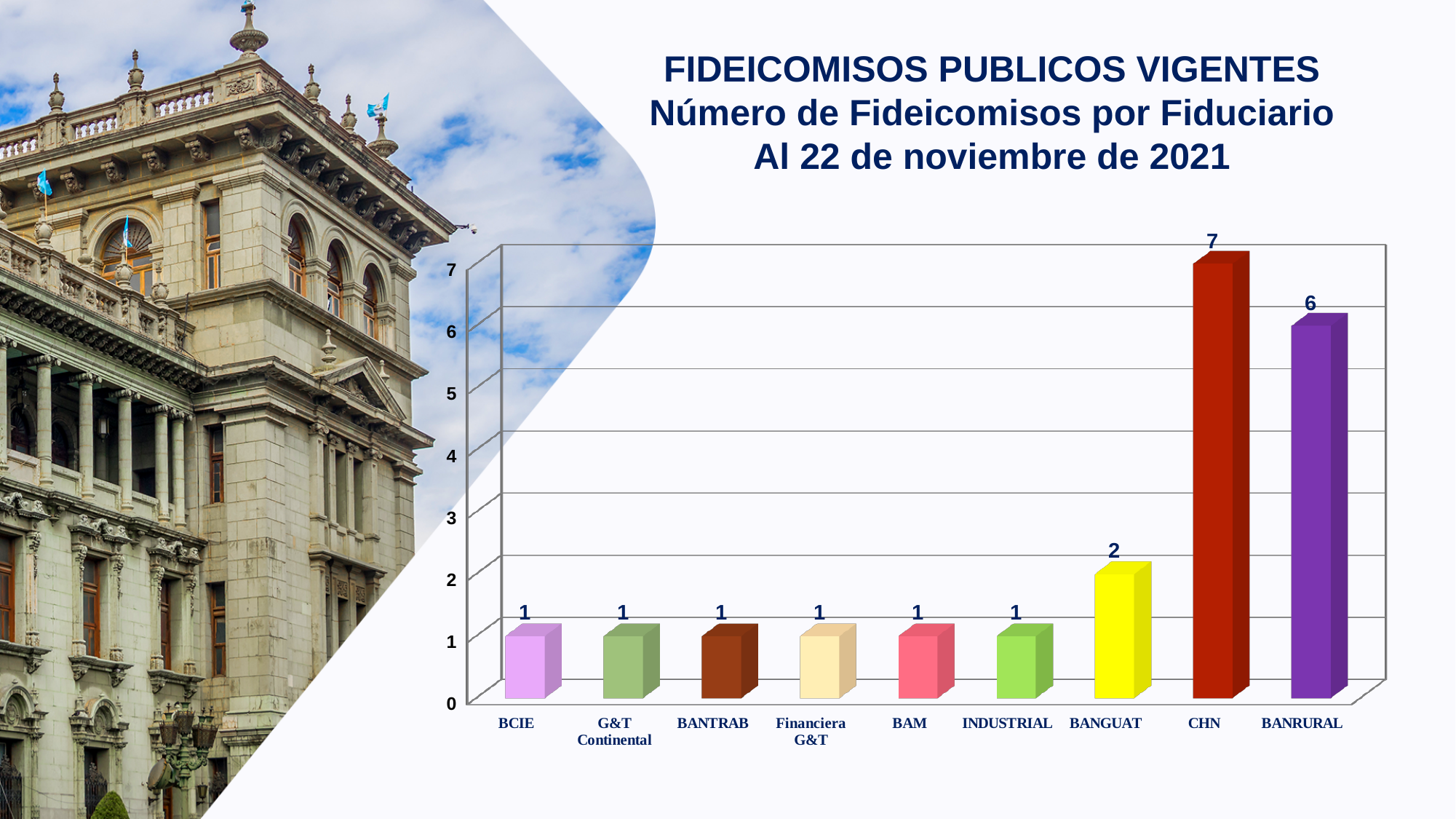
How many categories have a value of 1? 6 Which category has the highest value? CHN What is the value for BANTRAB? 1 What is the difference between the values for BANRURAL and BANGUAT? 4 What is the value for BANGUAT? 2 What is the difference between the values for CHN and BANRURAL? 1 What is the value for BANRURAL? 6 How many categories are shown on the x axis? 9 What is the value for CHN? 7 Which is larger, the value for BANGUAT or the value for INDUSTRIAL? BANGUAT What date is given in the chart title? 22 de noviembre de 2021 What kind of chart is shown on the slide? bar chart